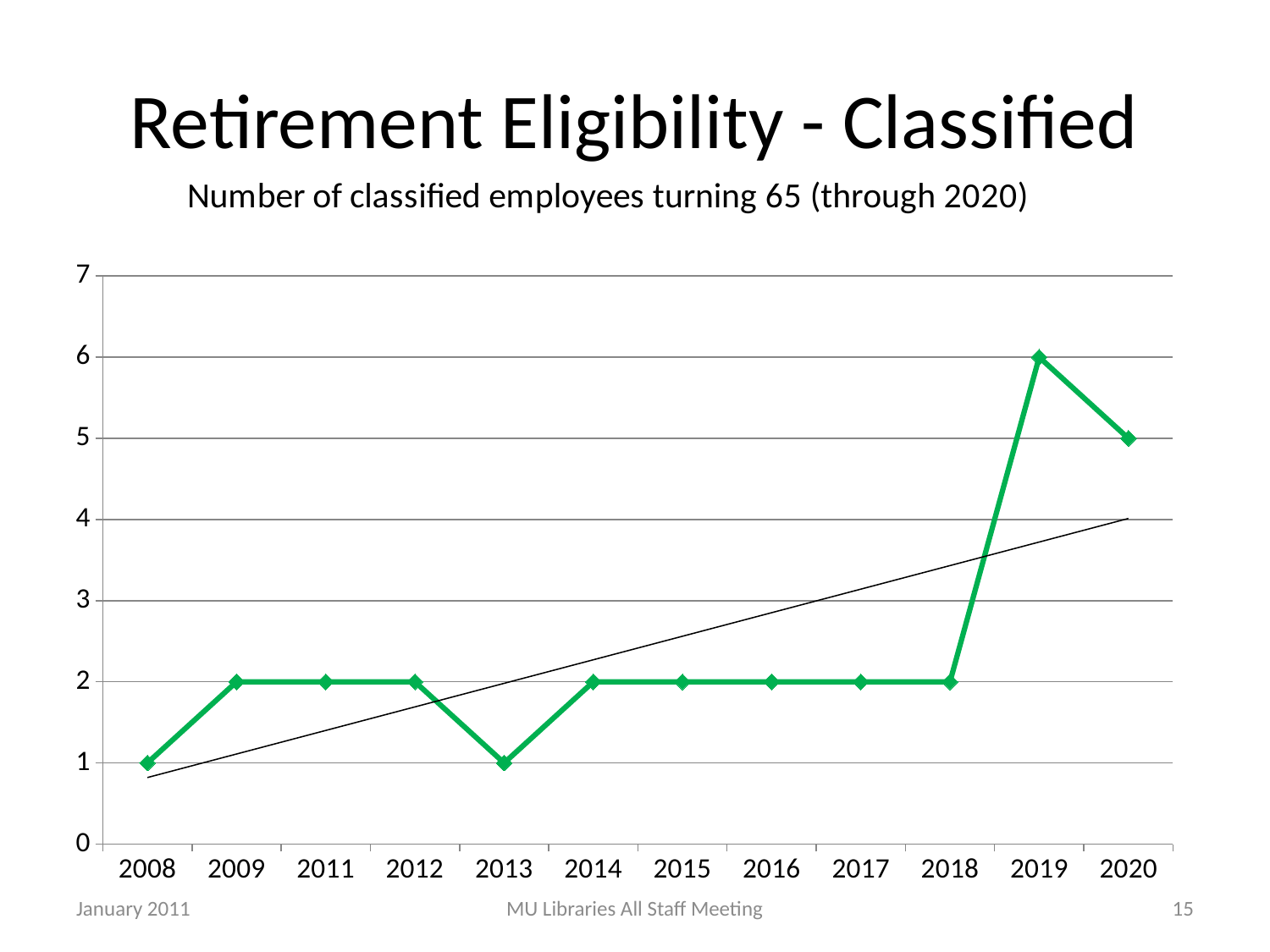
What is the value plotted for 2016? 2 What is the difference between the values for 2019 and 2018? 4 What is the value plotted for 2013? 1 How many years are plotted on the x axis? 12 What type of chart is shown on the slide? line chart What is the number of classified employees turning 65 in 2020? 5 What is the subtitle shown above the chart? Number of classified employees turning 65 (through 2020) Which year has the highest number of classified employees turning 65? 2019 Which year has the larger value, 2013 or 2014? 2014 What is the number of classified employees turning 65 in 2019? 6 What is the difference between the values for 2019 and 2020? 1 What is the value plotted for 2008? 1